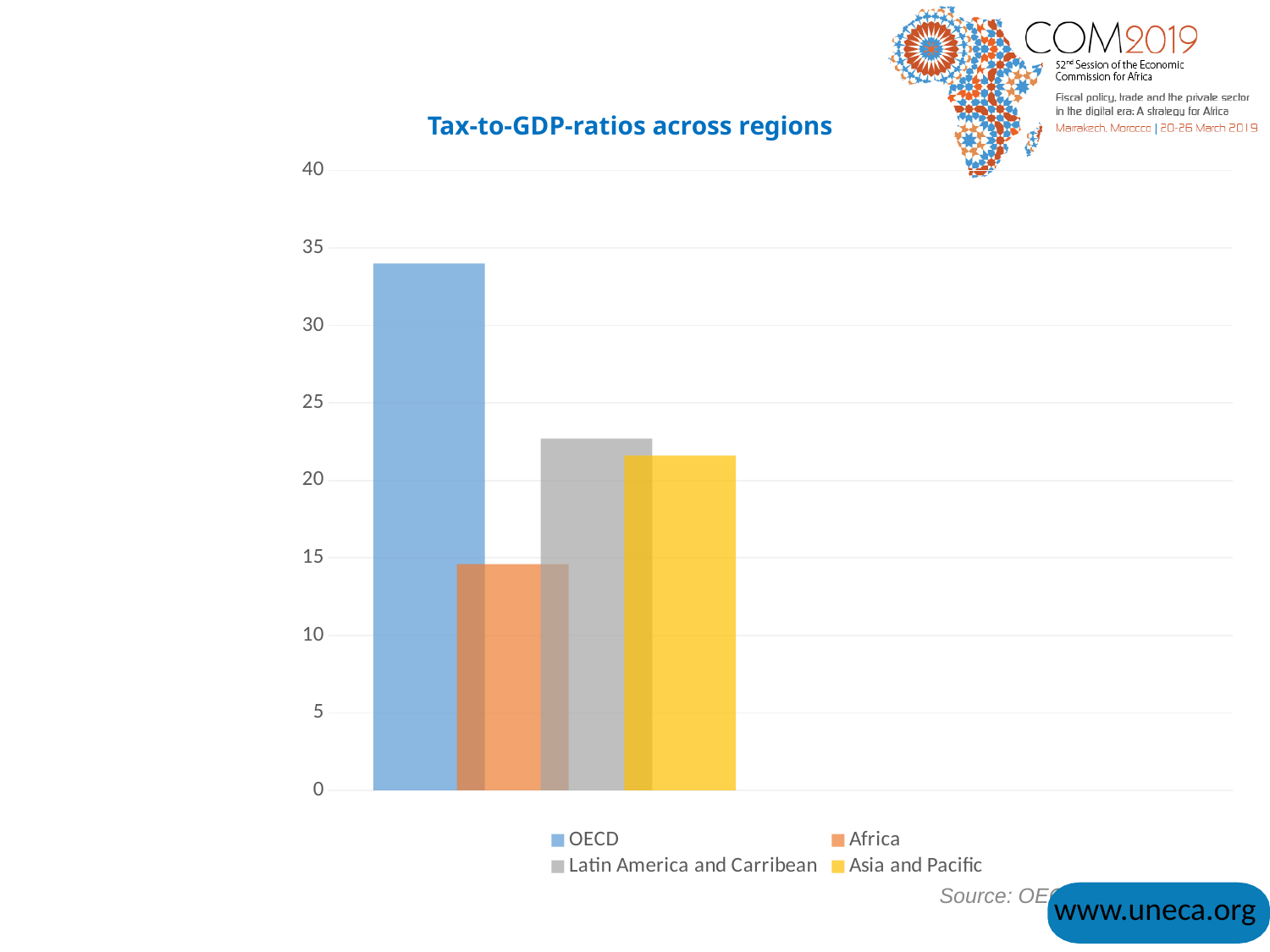
How many bars are plotted in the chart? 4 Which is larger, the value for OECD or the value for Africa? OECD What is the title of the chart? Tax-to-GDP-ratios across regions What kind of chart is shown on the slide? bar chart Which region has the highest tax-to-GDP ratio? OECD Is the value for OECD greater or less than 30? greater Which colour represents Asia and Pacific in the legend? yellow Is the value for Latin America and Carribean greater or less than 20? greater Is the value for Asia and Pacific greater or less than 25? less How many series does the legend list? 4 Which region has the lowest tax-to-GDP ratio? Africa